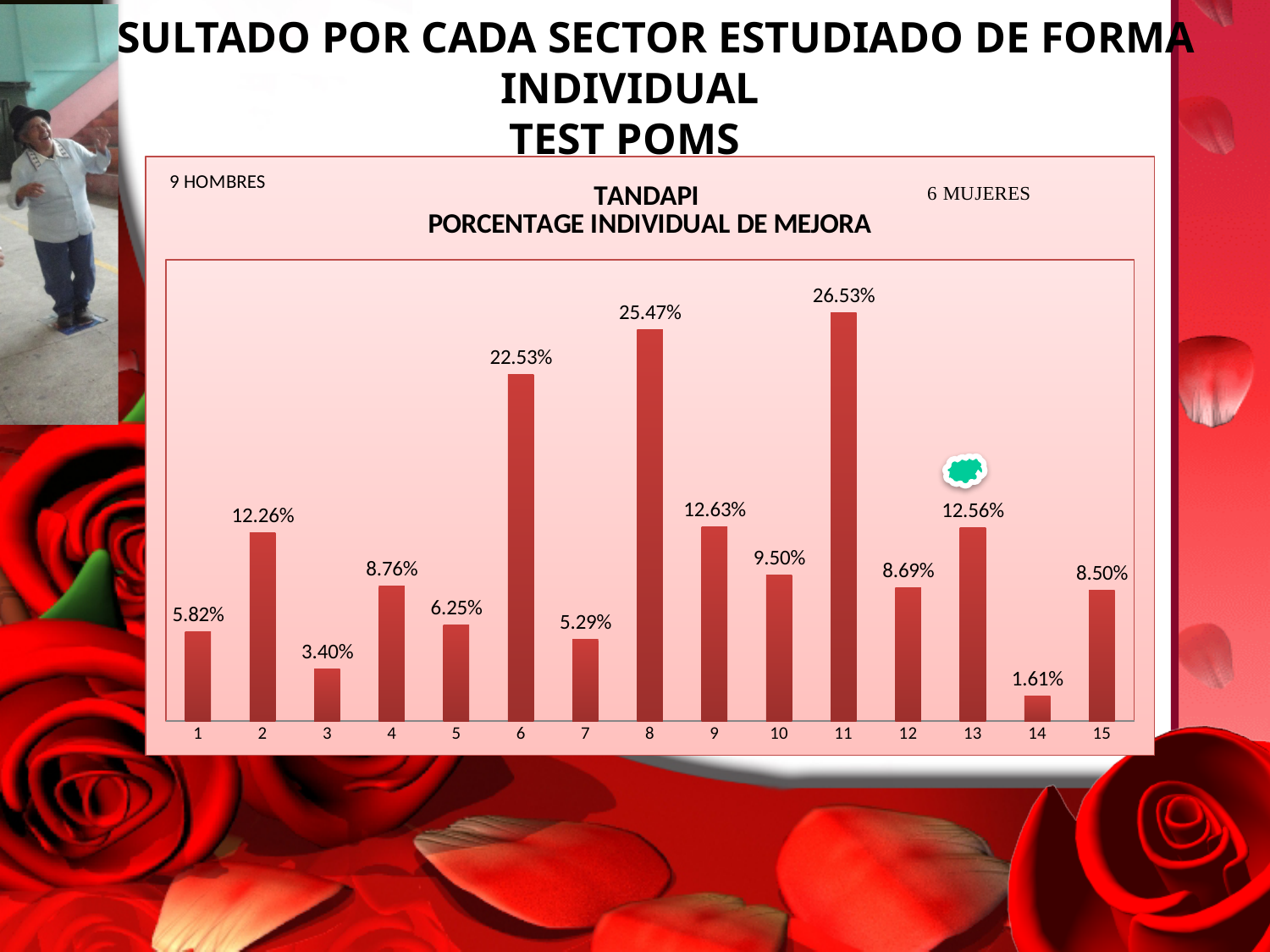
What is the value for category 6? 22.53% What is the value for category 11? 26.53% How many categories are shown on the x axis? 15 What is the value for category 14? 1.61% What is the difference between the values for category 8 and category 6? 2.94% Which is larger, the value for category 2 or the value for category 4? Category 2 What is the value for category 3? 3.40% Which category has the highest value? 11 What is the difference between the values for category 11 and category 14? 24.92% What is the title of the chart? TANDAPI PORCENTAGE INDIVIDUAL DE MEJORA What kind of chart is shown? Bar chart Which category has the lowest value? 14